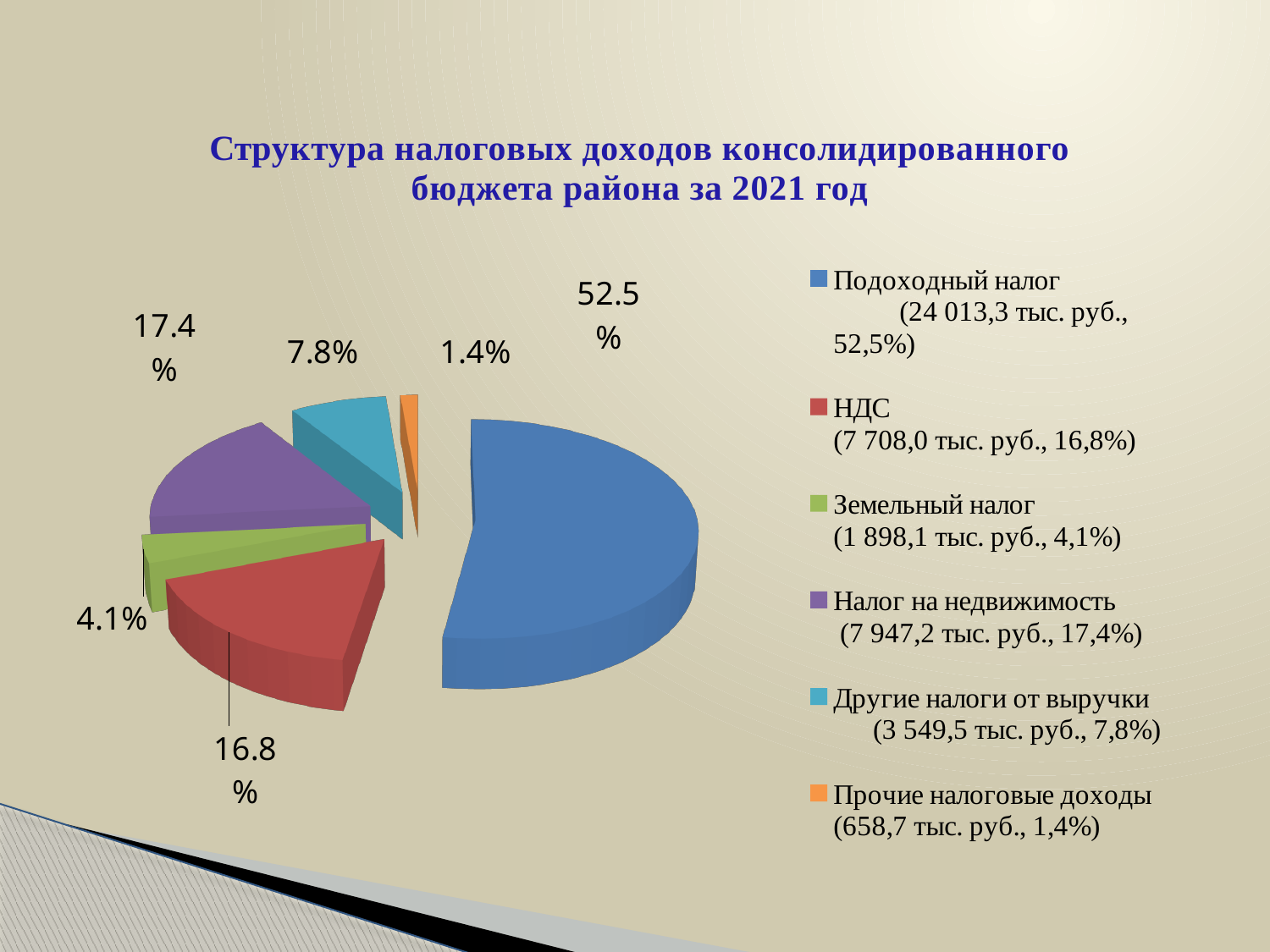
What colour is the slice for Подоходный налог? blue Which category has the largest share of the pie? Подоходный налог Which category has the smallest share of the pie? Прочие налоговые доходы What is the difference in percentage points between the shares of Подоходный налог and НДС? 35.7 Which has the larger share, Налог на недвижимость or НДС? Налог на недвижимость What percentage is shown for НДС? 16.8% What kind of chart is shown on the slide? pie chart How many categories does the pie chart have? 6 What is the title of the chart? Структура налоговых доходов консолидированного бюджета района за 2021 год What share of the pie does Подоходный налог take? 52.5% According to the legend, what amount in тыс. руб. is given for Земельный налог? 1 898,1 тыс. руб. What percentage is shown for Другие налоги от выручки? 7.8%